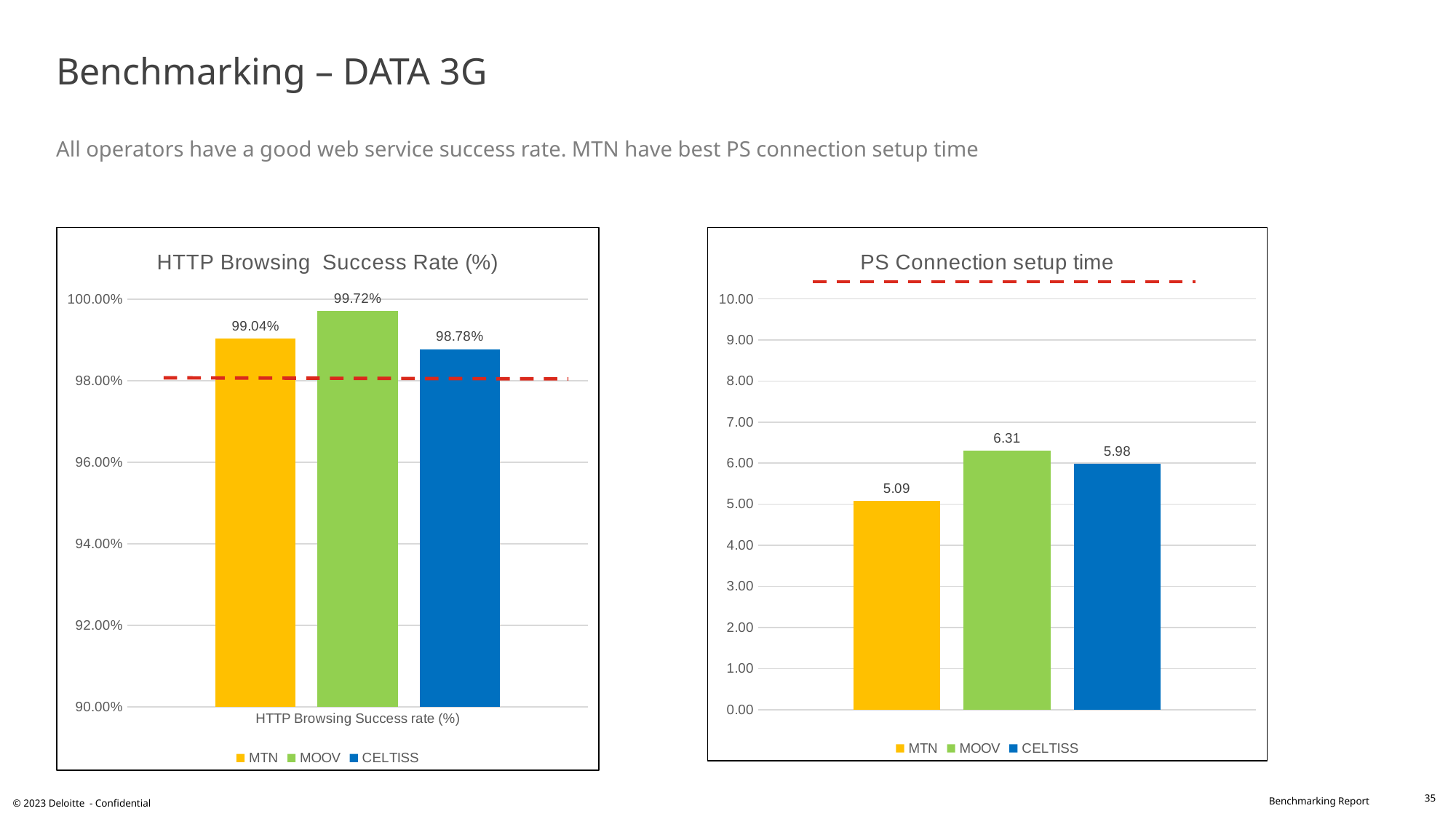
In the PS Connection setup time chart, what is the value for MTN? 5.09 In the HTTP Browsing Success Rate (%) chart, what is the value for CELTISS? 98.78% What kind of chart is the HTTP Browsing Success Rate (%) chart? bar chart In the PS Connection setup time chart, what is the difference between the MOOV and CELTISS values? 0.33 How many series does the legend of the PS Connection setup time chart list? 3 In the PS Connection setup time chart, is the value for CELTISS larger or smaller than the value for MTN? larger In the HTTP Browsing Success Rate (%) chart, which operator has the lowest success rate? CELTISS In the PS Connection setup time chart, which operator has the highest setup time? MOOV In the HTTP Browsing Success Rate (%) chart, what is the difference between the MOOV and MTN values? 0.68% In the HTTP Browsing Success Rate (%) chart, what is the value for MOOV? 99.72% In the PS Connection setup time chart, what is the value for MOOV? 6.31 In the HTTP Browsing Success Rate (%) chart, which operator has the highest success rate? MOOV